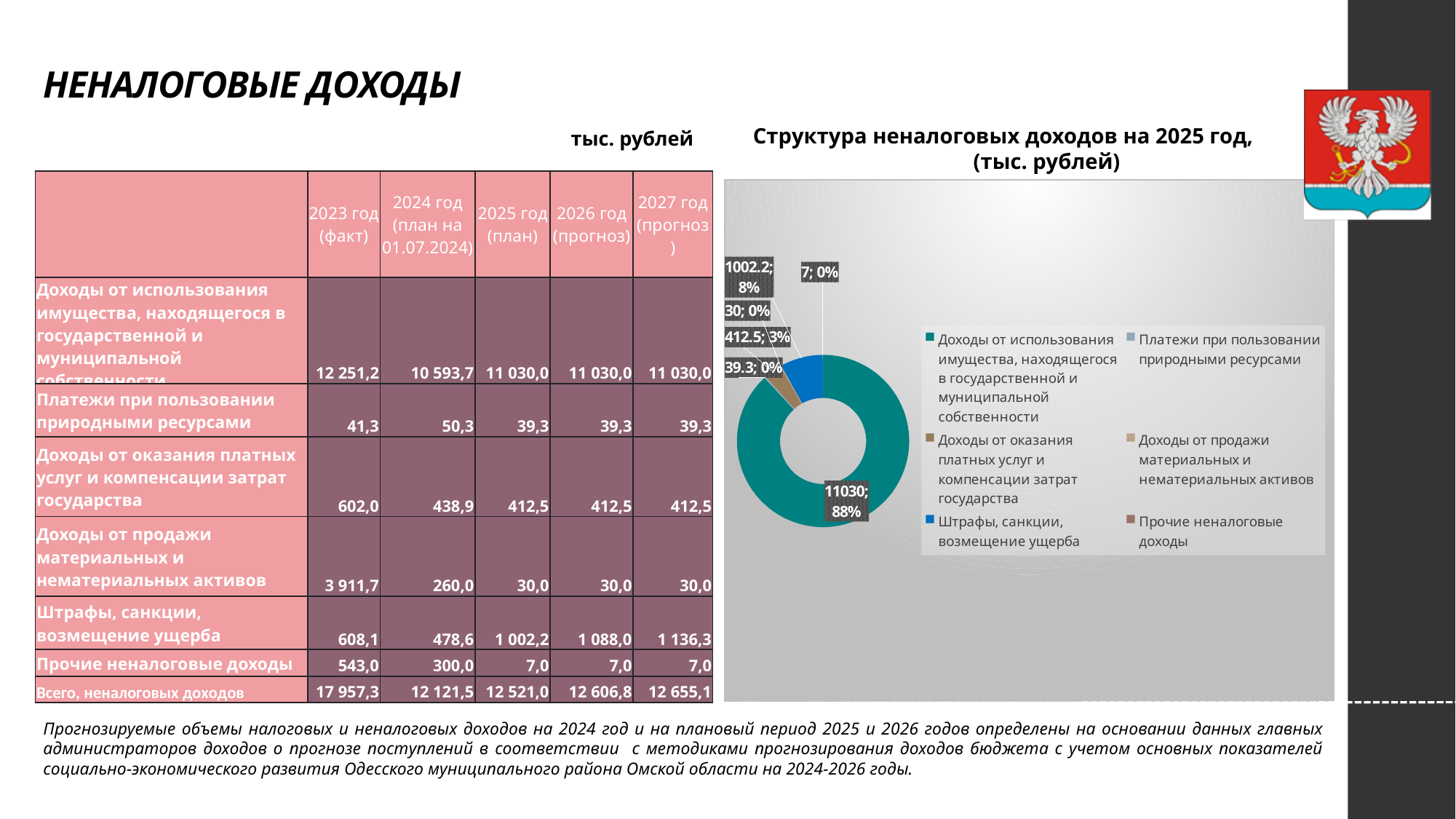
In the doughnut chart, what is the difference between the value for "Доходы от использования имущества" (11030) and the value for "Штрафы, санкции, возмещение ущерба" (1002.2)? 10027.8 How many categories does the legend of the doughnut chart list? 6 What is the title of the doughnut chart on the slide? Структура неналоговых доходов на 2025 год, (тыс. рублей) In the doughnut chart, which is larger: "Штрафы, санкции, возмещение ущерба" or "Доходы от оказания платных услуг и компенсации затрат государства"? Штрафы, санкции, возмещение ущерба In the doughnut chart, what share is shown for "Штрафы, санкции, возмещение ущерба"? 8% What kind of chart is shown under the title "Структура неналоговых доходов на 2025 год, (тыс. рублей)"? Doughnut (pie) chart Which category has the smallest slice in the doughnut chart? Прочие неналоговые доходы In the doughnut chart, what value is labelled for "Прочие неналоговые доходы"? 7 In the doughnut chart, what share is shown for "Доходы от оказания платных услуг и компенсации затрат государства"? 3% In the doughnut chart, what value is labelled for "Доходы от использования имущества, находящегося в государственной и муниципальной собственности"? 11030 Which category has the largest slice in the doughnut chart? Доходы от использования имущества, находящегося в государственной и муниципальной собственности In the doughnut chart, what value is labelled for "Доходы от оказания платных услуг и компенсации затрат государства"? 412.5